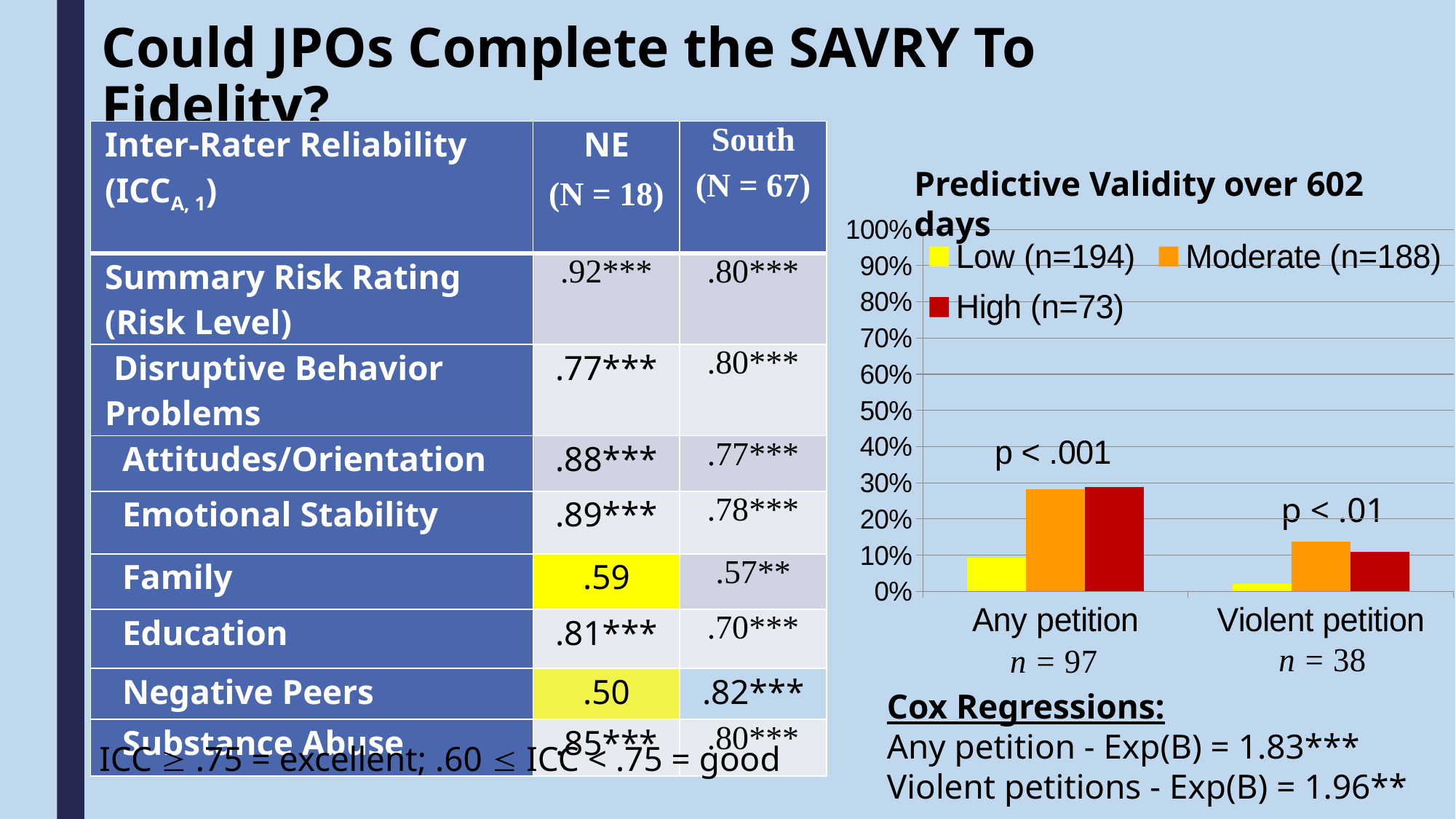
What is the title of the chart on the slide? Predictive Validity over 602 days In the Any petition category, which is larger: the value for Low (n=194) or the value for Moderate (n=188)? Moderate (n=188) Do the values for the Moderate (n=188) series rise or fall from Any petition to Violent petition? fall Is the value for Low (n=194) in the Violent petition category greater or less than 10%? less Is the value for Moderate (n=188) in the Any petition category greater or less than 20%? greater Is the value for Moderate (n=188) in the Violent petition category greater or less than 10%? greater How many categories are shown on the x axis of the chart? 2 What kind of chart is shown on the right side of the slide? bar chart How many series does the chart's legend list? 3 Which legend entry is shown in red in the chart? High (n=73)